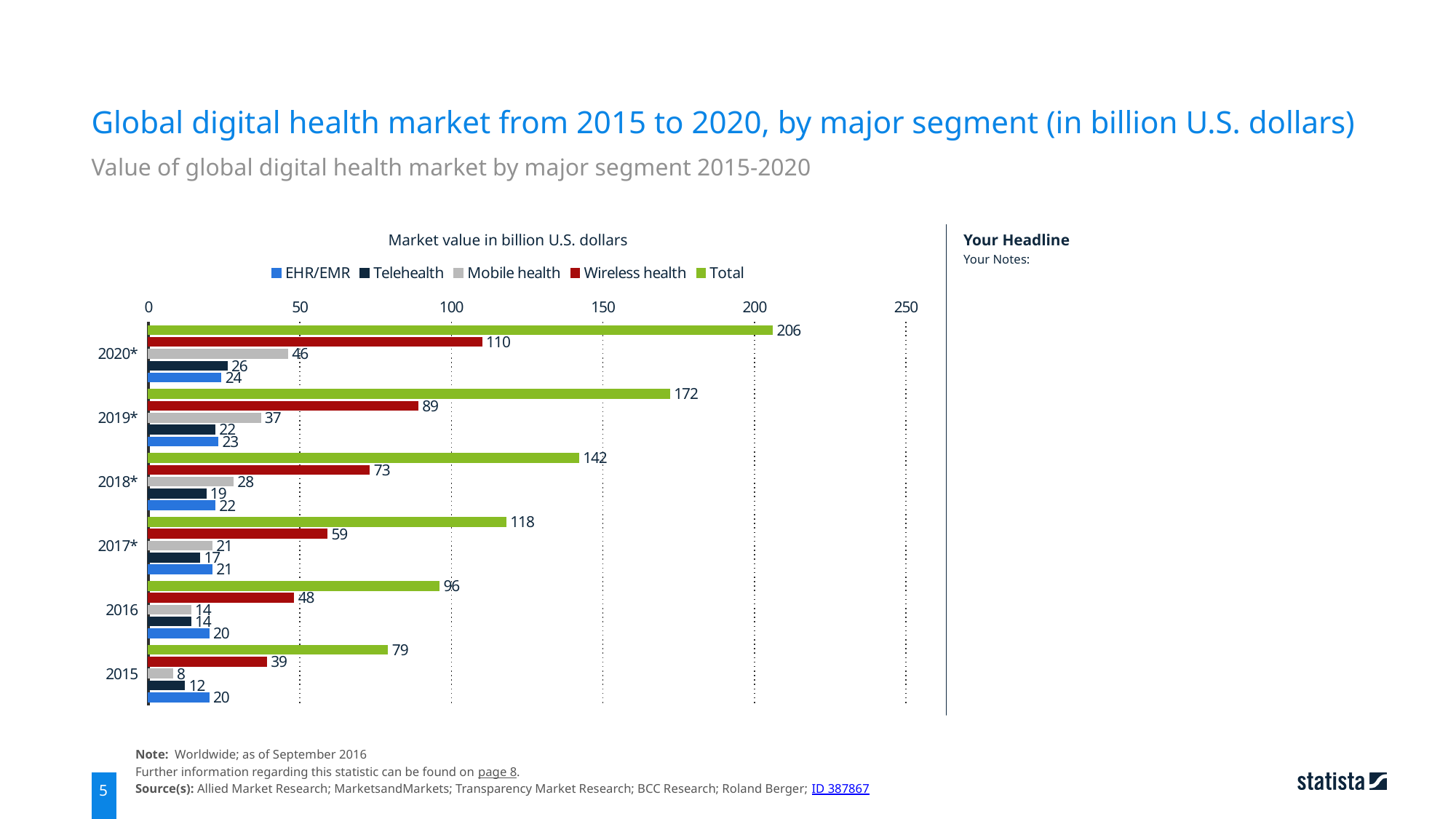
Which is larger in 2017*: the Mobile health value or the Telehealth value? Mobile health What colour represents the Total series in the legend? Green How many years are shown on the chart? 6 How many series does the legend list? 5 What is the Total market value for 2020*? 206 Which year has the lowest Wireless health value? 2015 Which year has the highest Total value? 2020* What is the difference between the Total values for 2020* and 2019*? 34 What is the Mobile health value for 2015? 8 What is the Wireless health value for 2018*? 73 What kind of chart is shown on the slide? Bar chart Does the Total value rise or fall from 2015 to 2020*? Rise